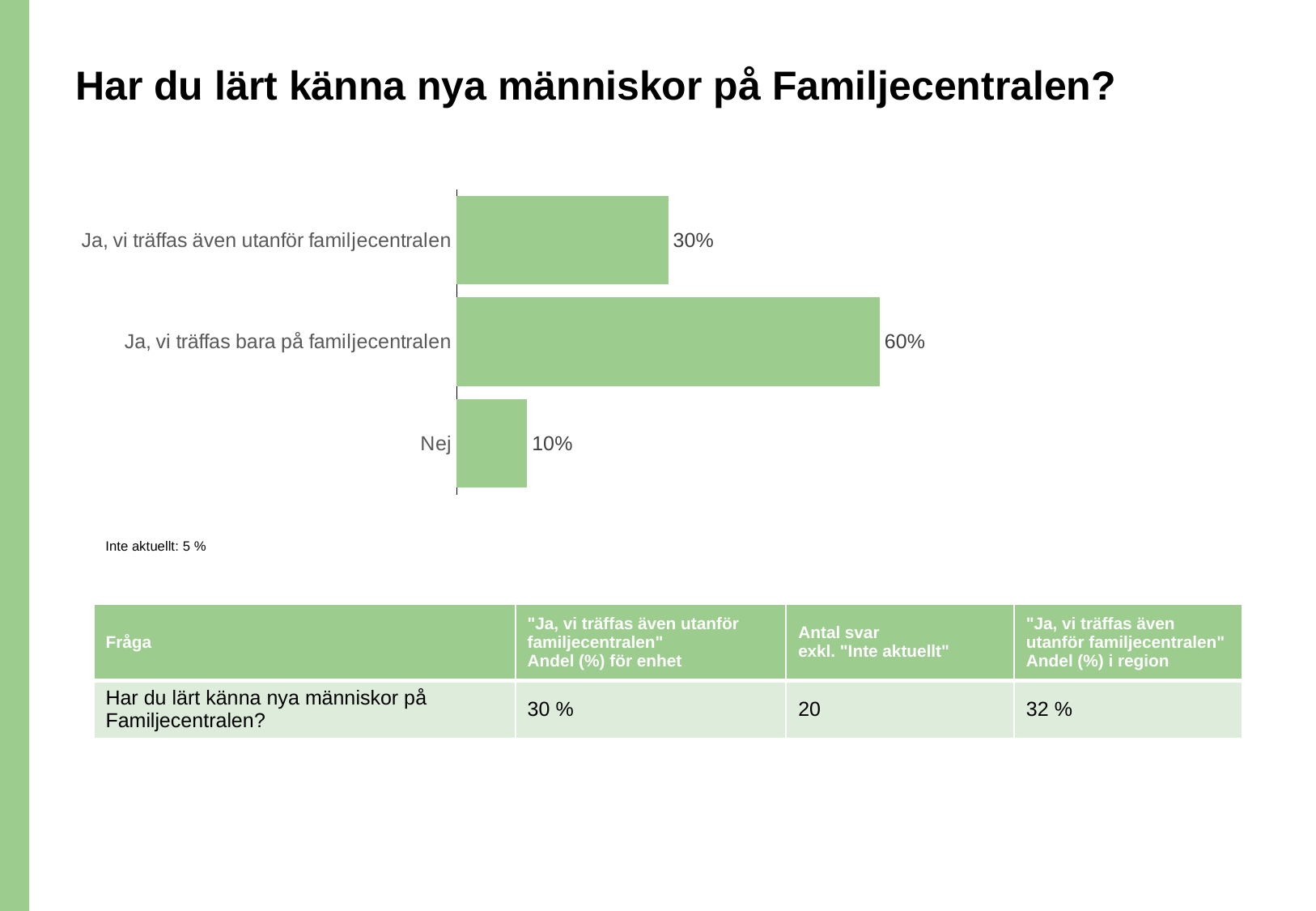
What is the title of the slide above the chart? Har du lärt känna nya människor på Familjecentralen? Which is larger, the value for "Nej" or the value for "Ja, vi träffas även utanför familjecentralen"? Ja, vi träffas även utanför familjecentralen What is the value for "Ja, vi träffas även utanför familjecentralen"? 30% What is the difference between "Ja, vi träffas även utanför familjecentralen" and "Nej"? 20% What is the value for "Ja, vi träffas bara på familjecentralen"? 60% Which category has the highest value? Ja, vi träffas bara på familjecentralen What is the value for "Nej"? 10% Which category has the lowest value? Nej What percentage is given for "Inte aktuellt" below the chart? 5 % What is the difference between "Ja, vi träffas bara på familjecentralen" and "Ja, vi träffas även utanför familjecentralen"? 30% What kind of chart is shown on the slide? Bar chart How many categories does the chart show? 3